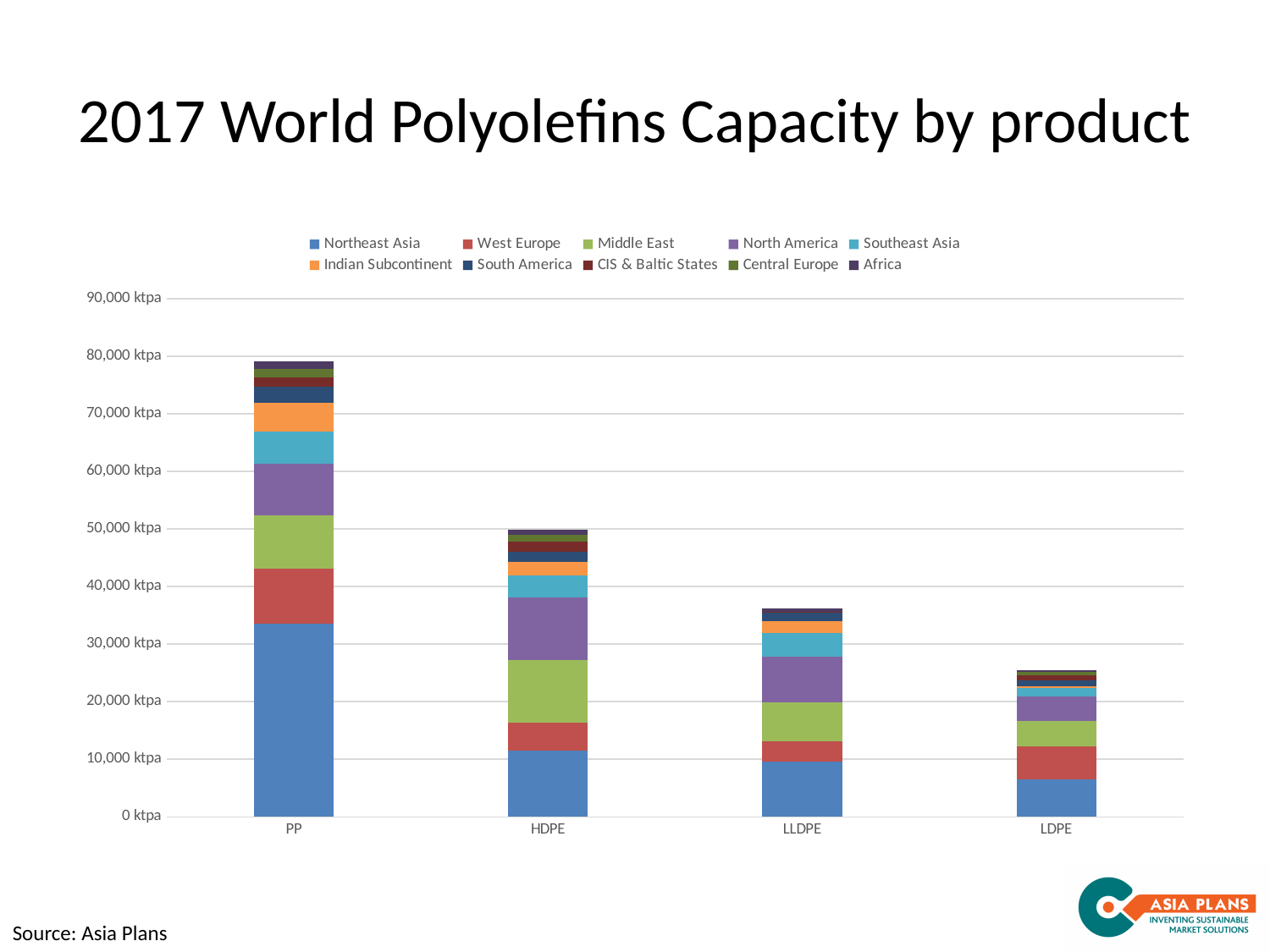
How many product categories are shown on the x axis? 4 What kind of chart is shown on the slide? Stacked bar chart Which has the larger total capacity, HDPE or LLDPE? HDPE Which product has the lowest total capacity? LDPE Is the total capacity for PP greater or less than 70,000 ktpa? greater Which product has the highest total capacity? PP Is the total capacity for LLDPE greater or less than 30,000 ktpa? greater How many series does the legend list? 10 What is the title of the chart? 2017 World Polyolefins Capacity by product Is the total capacity for HDPE greater or less than 60,000 ktpa? less